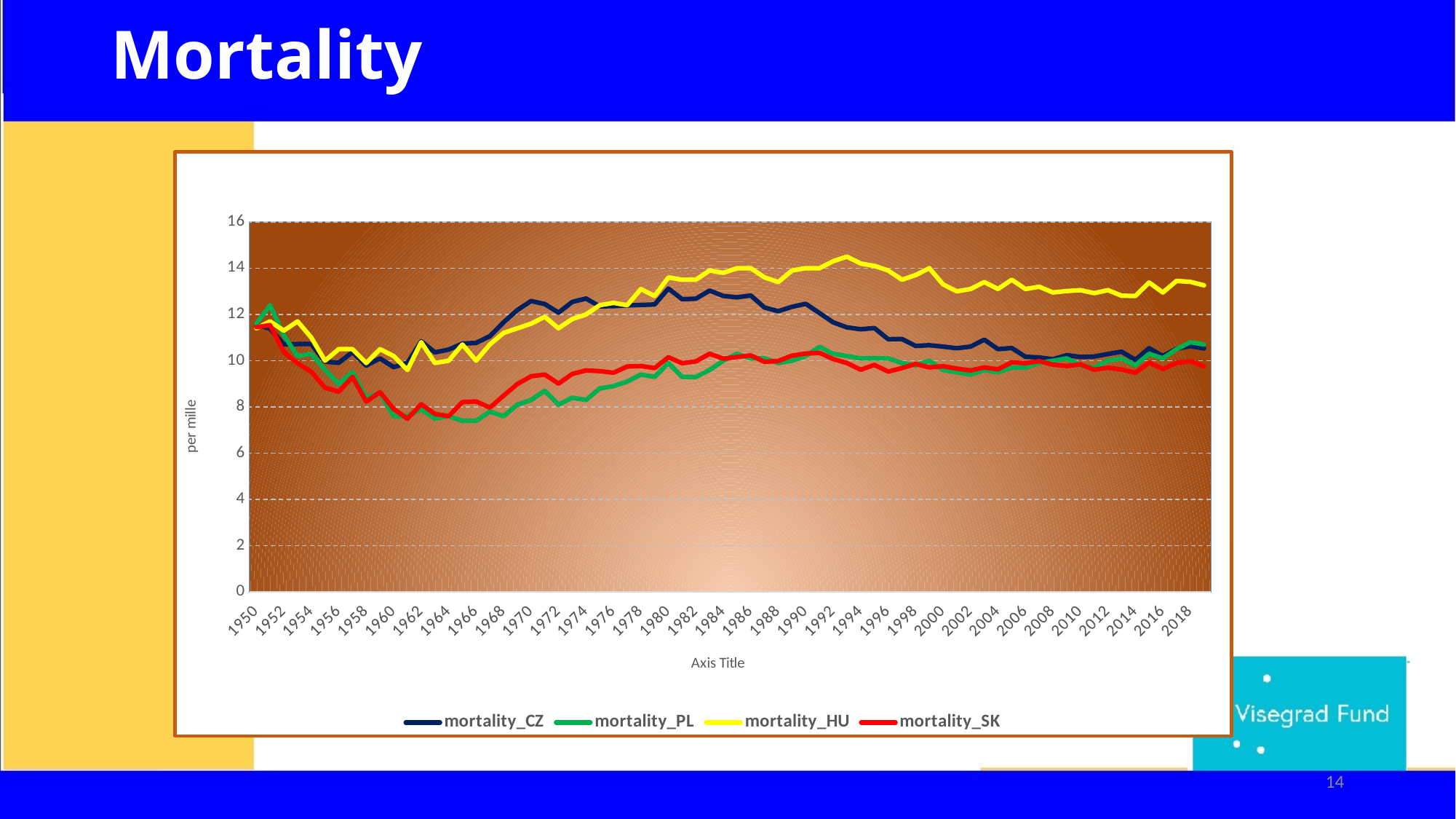
Which series has the highest value in 2018? mortality_HU How many series does the legend list? 4 What are the series names listed in the legend? mortality_CZ, mortality_PL, mortality_HU, mortality_SK What is the label on the vertical axis? per mille Is the value for mortality_PL in 1964 greater or less than 8? less Does mortality_HU generally rise or fall between 1960 and 1994? rise In 1970, which series has the higher value, mortality_CZ or mortality_SK? mortality_CZ Is the value for mortality_HU in 1986 greater or less than 12? greater In 1994, which series has the higher value, mortality_HU or mortality_PL? mortality_HU Is the value for mortality_CZ in 1980 greater or less than 12? greater What kind of chart is shown on the slide? line chart